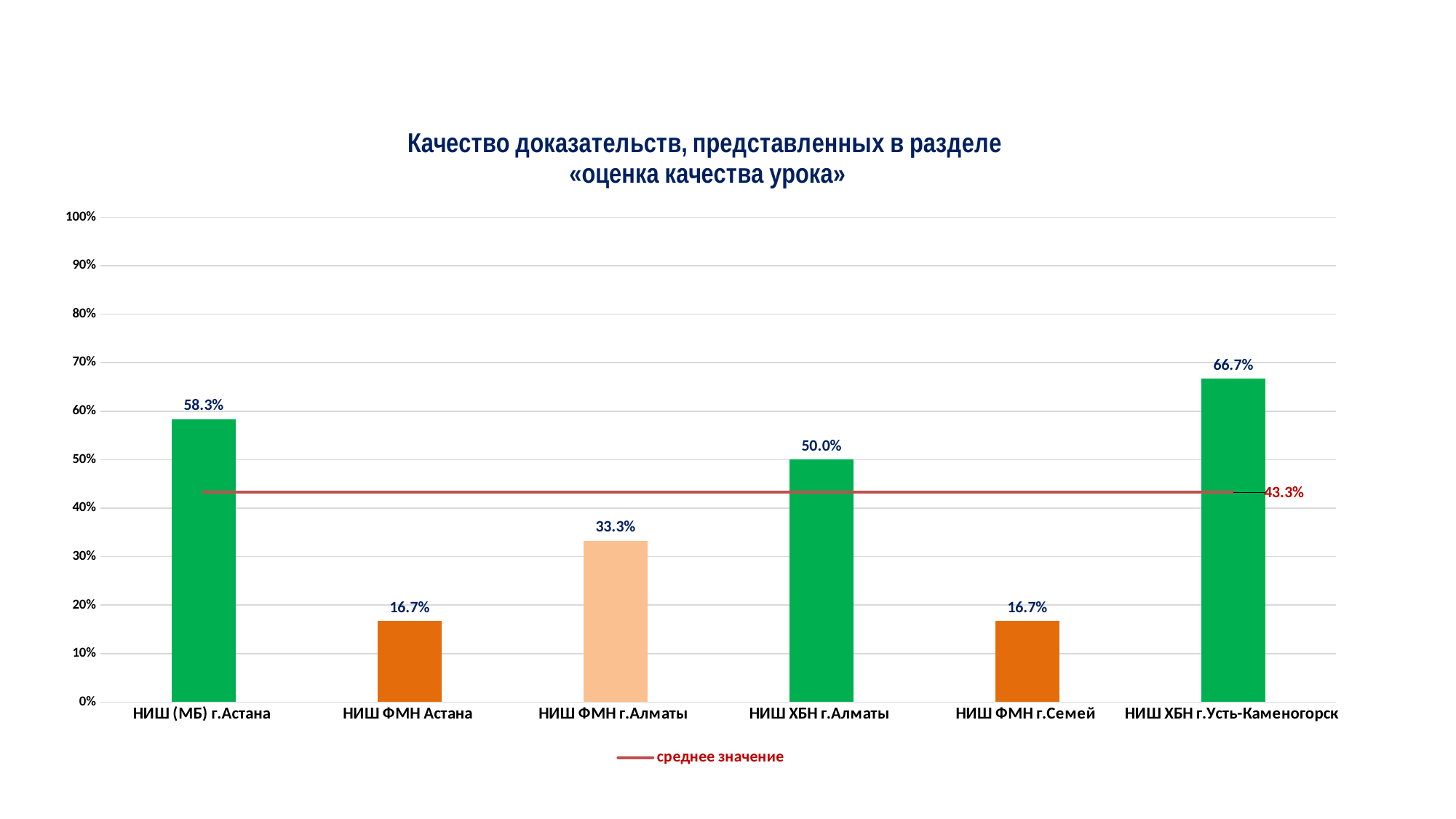
What is the title of the chart? Качество доказательств, представленных в разделе «оценка качества урока» Is the value for НИШ ФМН г.Семей greater or less than 20%? less What is the value for НИШ ХБН г.Усть-Каменогорск? 66.7% What is the value for НИШ (МБ) г.Астана? 58.3% What kind of chart is this? bar chart How many categories are shown on the x axis? 6 What is the value for НИШ ХБН г.Алматы? 50.0% Which category has the highest value? НИШ ХБН г.Усть-Каменогорск What is the value of the среднее значение line? 43.3% What is the difference between the values for НИШ ХБН г.Усть-Каменогорск and НИШ (МБ) г.Астана? 8.4% Which is larger, the value for НИШ ХБН г.Алматы or the value for НИШ ФМН г.Алматы? НИШ ХБН г.Алматы What is the value for НИШ ФМН г.Алматы? 33.3%